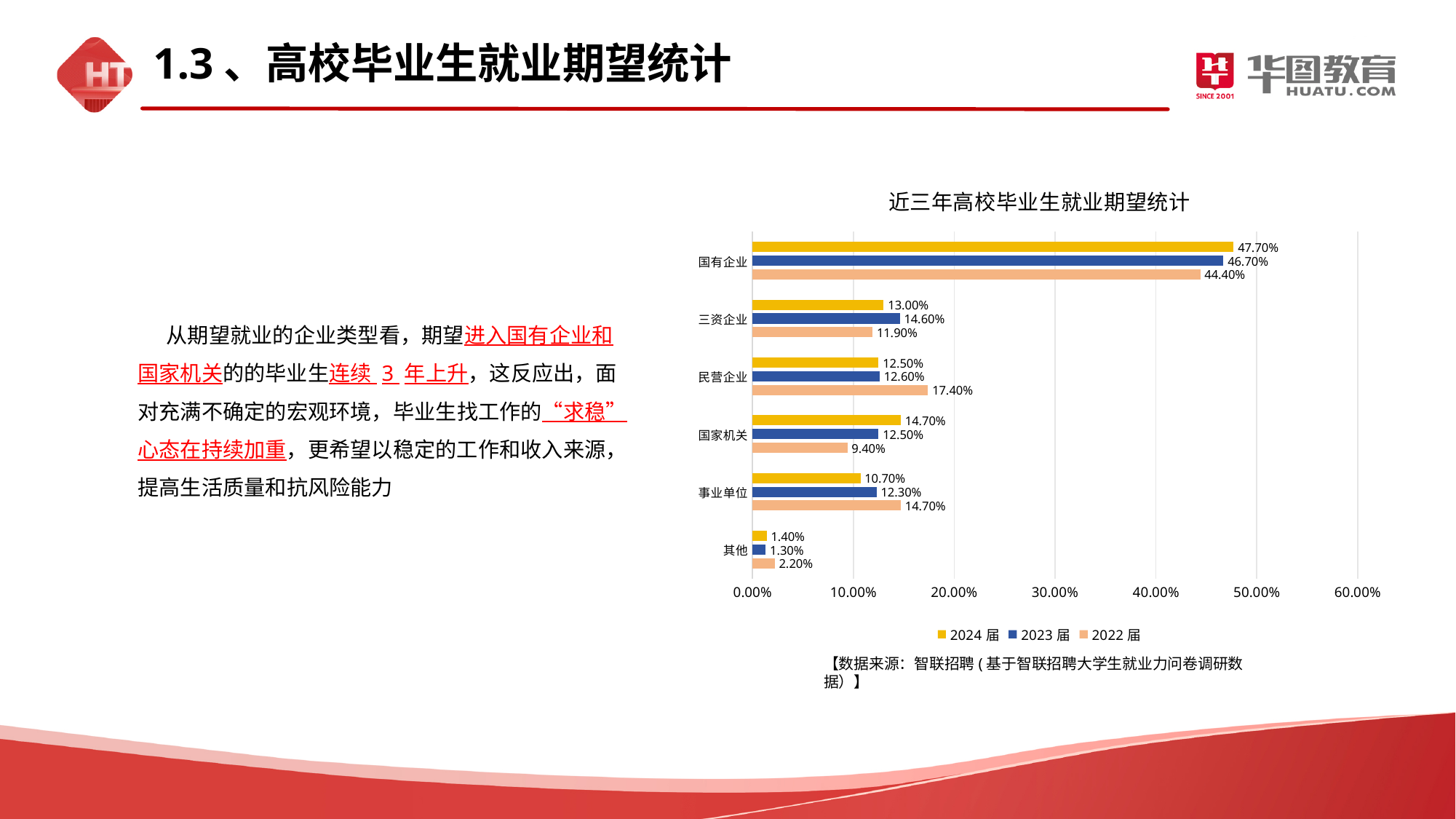
What is the value for 国家机关 in the 2022 届 series? 9.40% How many series does the legend list? 3 Is the value for 国有企业 in the 2023 届 series greater or less than 40.00%? greater Which category has the highest value in the 2024 届 series? 国有企业 What is the value for 事业单位 in the 2023 届 series? 12.30% What is the title of the chart? 近三年高校毕业生就业期望统计 Which is larger for 民营企业: the 2022 届 value or the 2024 届 value? 2022 届 What kind of chart is shown on the slide? Bar chart What is the difference between the 2024 届 and 2022 届 values for 国有企业? 3.30% How many categories are shown on the chart? 6 What is the value for 国有企业 in the 2024 届 series? 47.70% Which category has the lowest value in the 2022 届 series? 其他